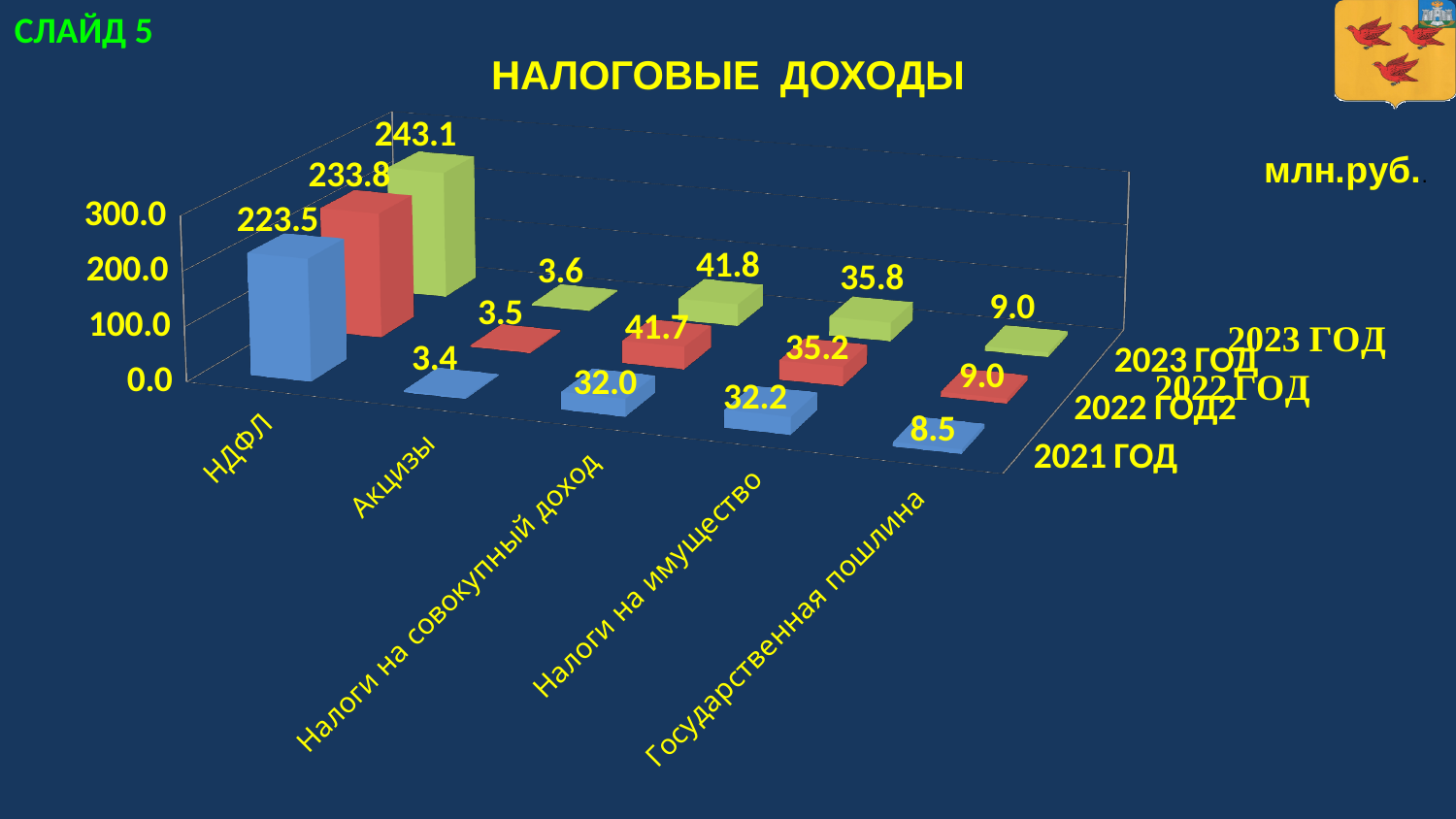
How many years (series) are plotted in the chart? 3 How many categories are shown on the x axis? 5 What is the value for Государственная пошлина in 2023 ГОД? 9.0 What is the difference between the НДФЛ values for 2023 ГОД and 2021 ГОД? 19.6 What kind of chart is shown on the slide? bar chart What unit is indicated for the chart values? млн.руб. Which category has the lowest value in 2021 ГОД? Акцизы Do the НДФЛ values rise or fall from 2021 ГОД to 2023 ГОД? rise What is the value for НДФЛ in 2021 ГОД? 223.5 Which category has the highest value in 2023 ГОД? НДФЛ Which is larger: Налоги на имущество in 2021 ГОД or Налоги на совокупный доход in 2021 ГОД? Налоги на имущество What is the value for Налоги на совокупный доход in 2022 ГОД? 41.7